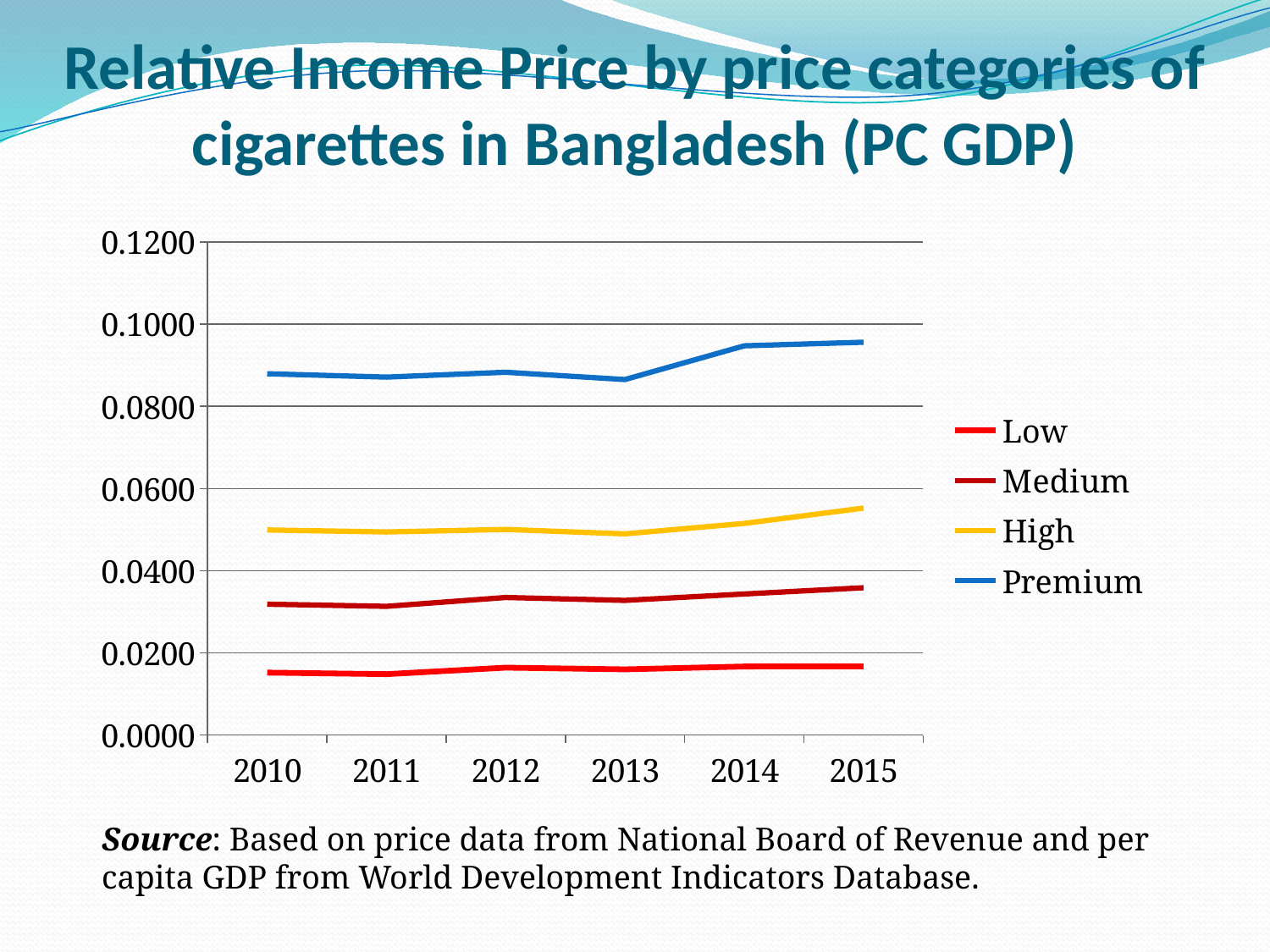
How many years are shown on the x axis? 6 Is the value for Medium in 2015 greater or less than 0.0400? less What kind of chart is shown on the slide? line chart Does the Premium line rise or fall overall from 2010 to 2015? rise Is the value for Premium in 2010 greater or less than 0.0800? greater How many series does the legend list? 4 Which price category has the lowest relative income price across all years? Low Which is larger for Premium: the value in 2013 or the value in 2014? 2014 Is the value for Low in 2013 greater or less than 0.0200? less Which price category has the highest relative income price across all years? Premium